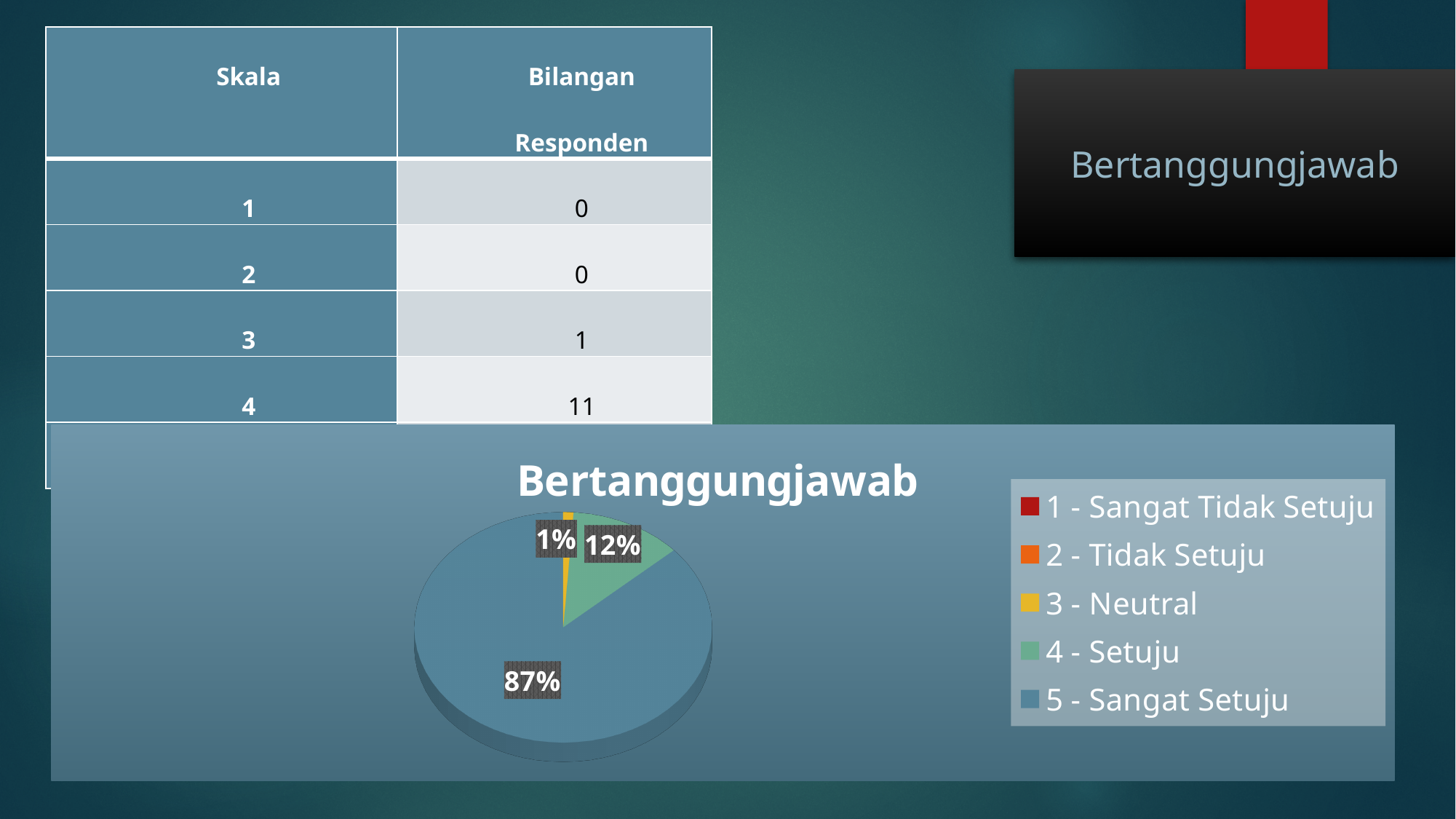
What share of the pie does '4 - Setuju' take? 12% Which category has the largest slice of the pie? 5 - Sangat Setuju What kind of chart is shown on the slide? pie chart What share of the pie does '5 - Sangat Setuju' take? 87% What is the difference in percentage points between the '5 - Sangat Setuju' slice and the '4 - Setuju' slice? 75% What share of the pie does '3 - Neutral' take? 1% Which of the labelled slices is the smallest? 3 - Neutral Which is larger, the slice for '4 - Setuju' or the slice for '3 - Neutral'? 4 - Setuju How many slices in the pie chart have a percentage label? 3 How many entries does the pie chart's legend list? 5 What colour is the '5 - Sangat Setuju' slice in the pie chart? blue What is the title of the pie chart? Bertanggungjawab